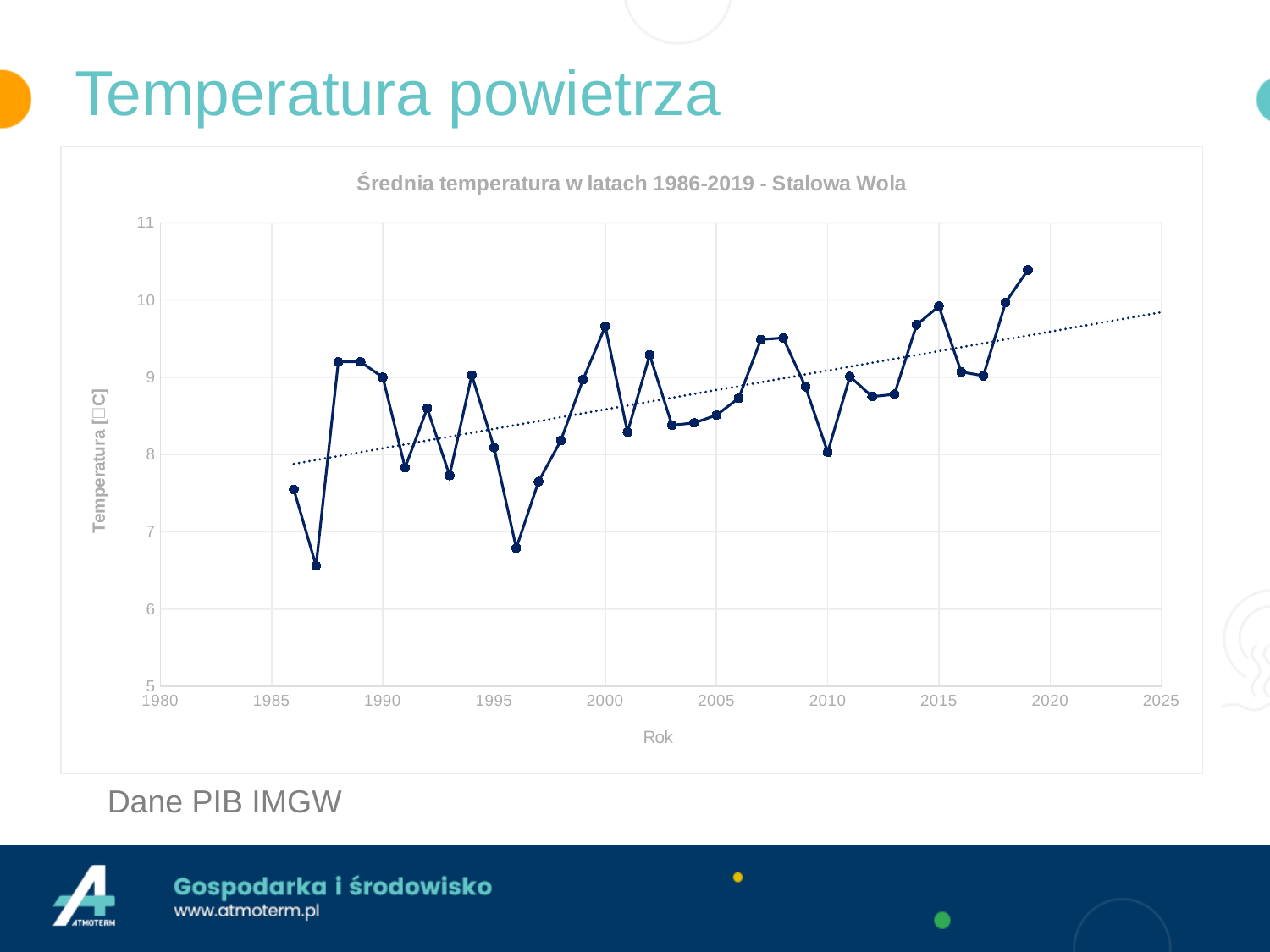
Which year has the highest average temperature? 2019 Is the value for 1996 greater or less than 7? less What is the label of the x axis? Rok Which year has the higher average temperature, 1986 or 1988? 1988 Does the average temperature generally rise or fall over the years shown? rise What is the title of the chart? Średnia temperatura w latach 1986-2019 - Stalowa Wola Which year has the higher average temperature, 2007 or 2010? 2007 What kind of chart is shown on the slide? line chart Is the value for 1986 greater or less than 8? less Is the value for 2000 greater or less than 9? greater Which year has the lowest average temperature? 1987